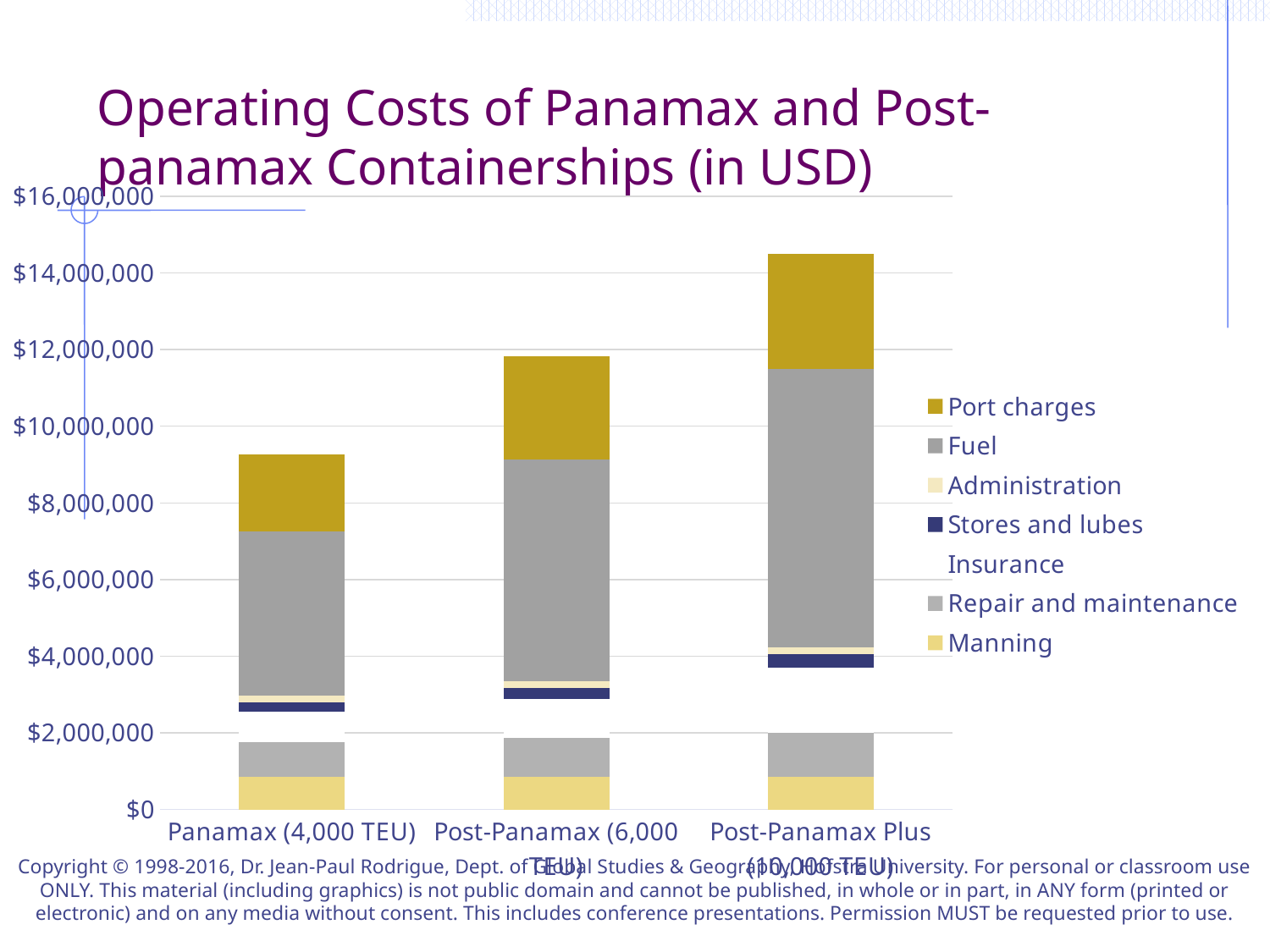
How many series does the legend list? 7 Is the total operating cost for Panamax (4,000 TEU) greater or less than $10,000,000? less Which has a larger total operating cost, Panamax (4,000 TEU) or Post-Panamax (6,000 TEU)? Post-Panamax (6,000 TEU) How many ship categories are plotted on the x axis? 3 What is the title of the chart? Operating Costs of Panamax and Post-panamax Containerships (in USD) Is the total operating cost for Post-Panamax Plus greater or less than $14,000,000? greater Is the total operating cost for Post-Panamax (6,000 TEU) greater or less than $12,000,000? less Do total operating costs rise or fall moving from Panamax to Post-Panamax Plus along the x axis? Rise Which ship category has the lowest total operating cost? Panamax (4,000 TEU) Which series is listed first in the legend? Port charges What kind of chart is shown on the slide? Stacked bar chart Which ship category has the highest total operating cost? Post-Panamax Plus